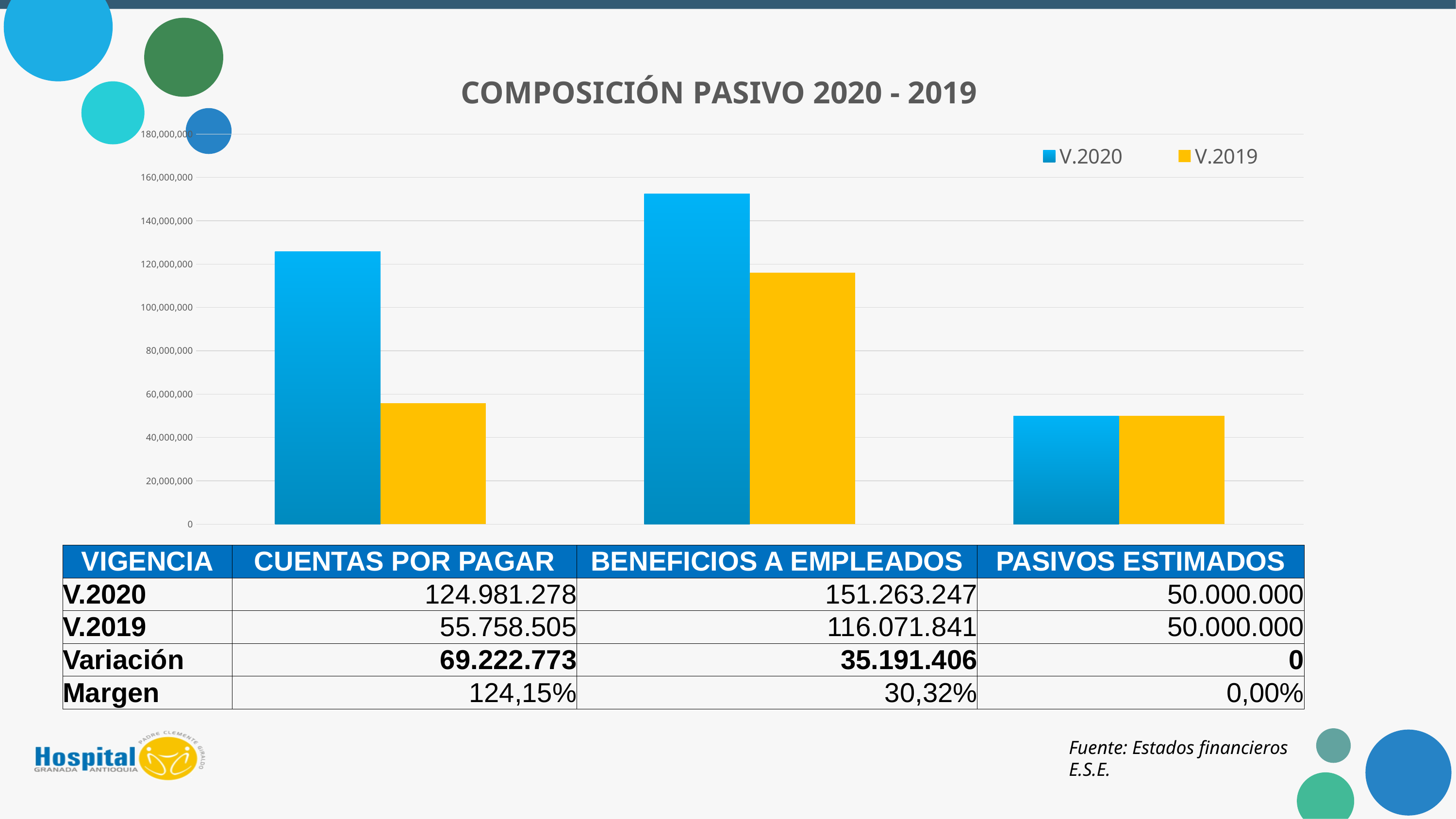
How many series does the chart legend list? 2 What is the V.2020 value for CUENTAS POR PAGAR? 124.981.278 What is the V.2019 value for BENEFICIOS A EMPLEADOS? 116.071.841 Which colour represents the V.2019 series in the chart? yellow Is the V.2020 bar for BENEFICIOS A EMPLEADOS greater or less than 140,000,000? greater Which is larger, the V.2020 value for CUENTAS POR PAGAR or the V.2019 value for CUENTAS POR PAGAR? V.2020 Which category has the highest V.2020 value? BENEFICIOS A EMPLEADOS Which category has the lowest V.2019 value? PASIVOS ESTIMADOS What kind of chart is shown on the slide? bar chart What is the difference between the V.2020 and V.2019 values for CUENTAS POR PAGAR? 69.222.773 What is the title of the chart? COMPOSICIÓN PASIVO 2020 - 2019 How many category groups of bars are plotted in the chart? 3